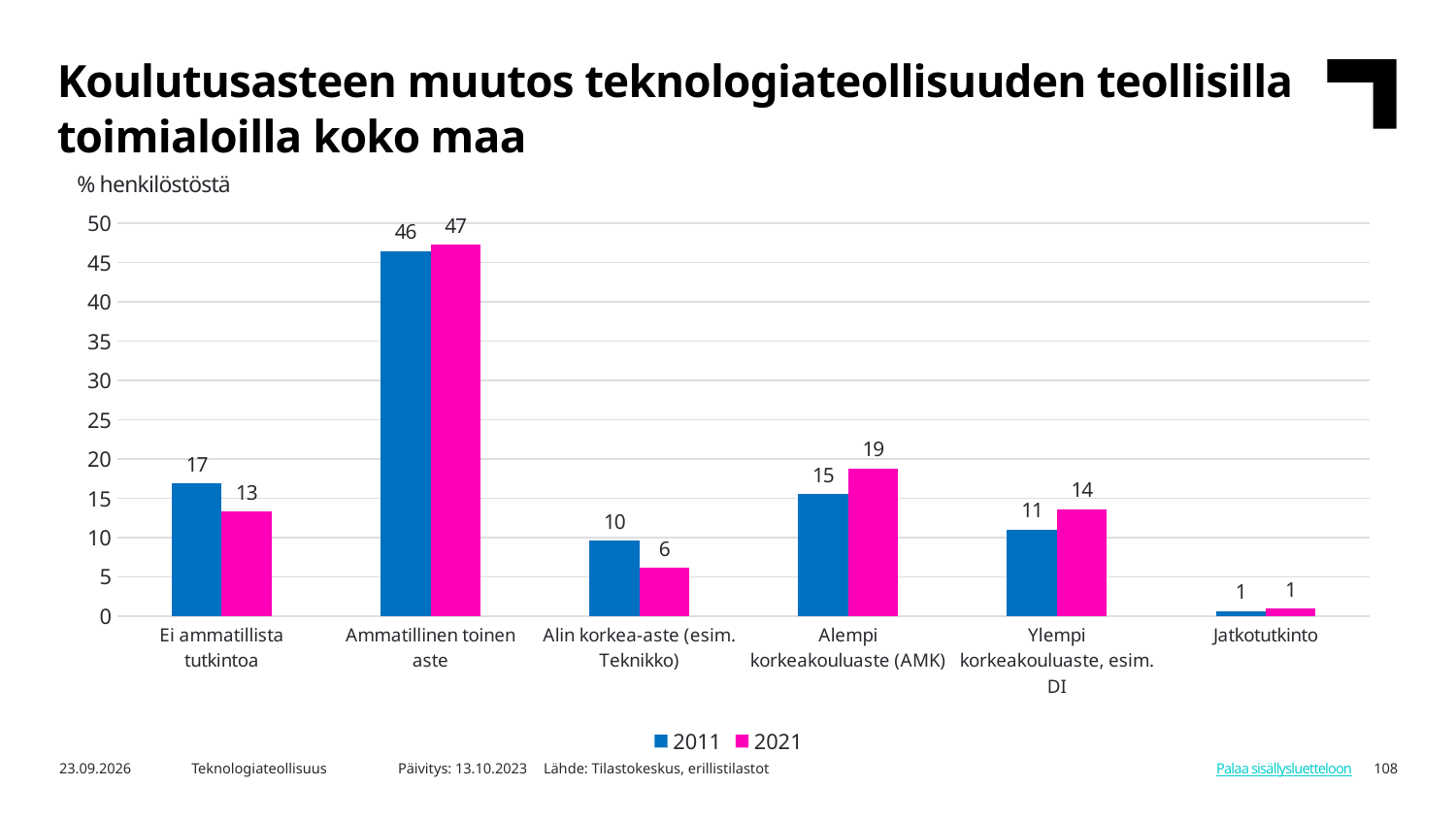
What kind of chart is shown on the slide? bar chart What unit label is shown above the chart? % henkilöstöstä For Ylempi korkeakouluaste, esim. DI, which year has the larger value, 2011 or 2021? 2021 Which category has the highest 2021 value? Ammatillinen toinen aste How many categories are shown on the x axis? 6 Which category has the lowest 2011 value? Jatkotutkinto What is the 2011 value for Ammatillinen toinen aste? 46 Is the 2011 value for Ei ammatillista tutkintoa greater or less than 15? greater What is the 2021 value for Alempi korkeakouluaste (AMK)? 19 What is the difference between the 2011 and 2021 values for Alin korkea-aste (esim. Teknikko)? 4 How many series does the legend list? 2 What is the 2021 value for Ei ammatillista tutkintoa? 13